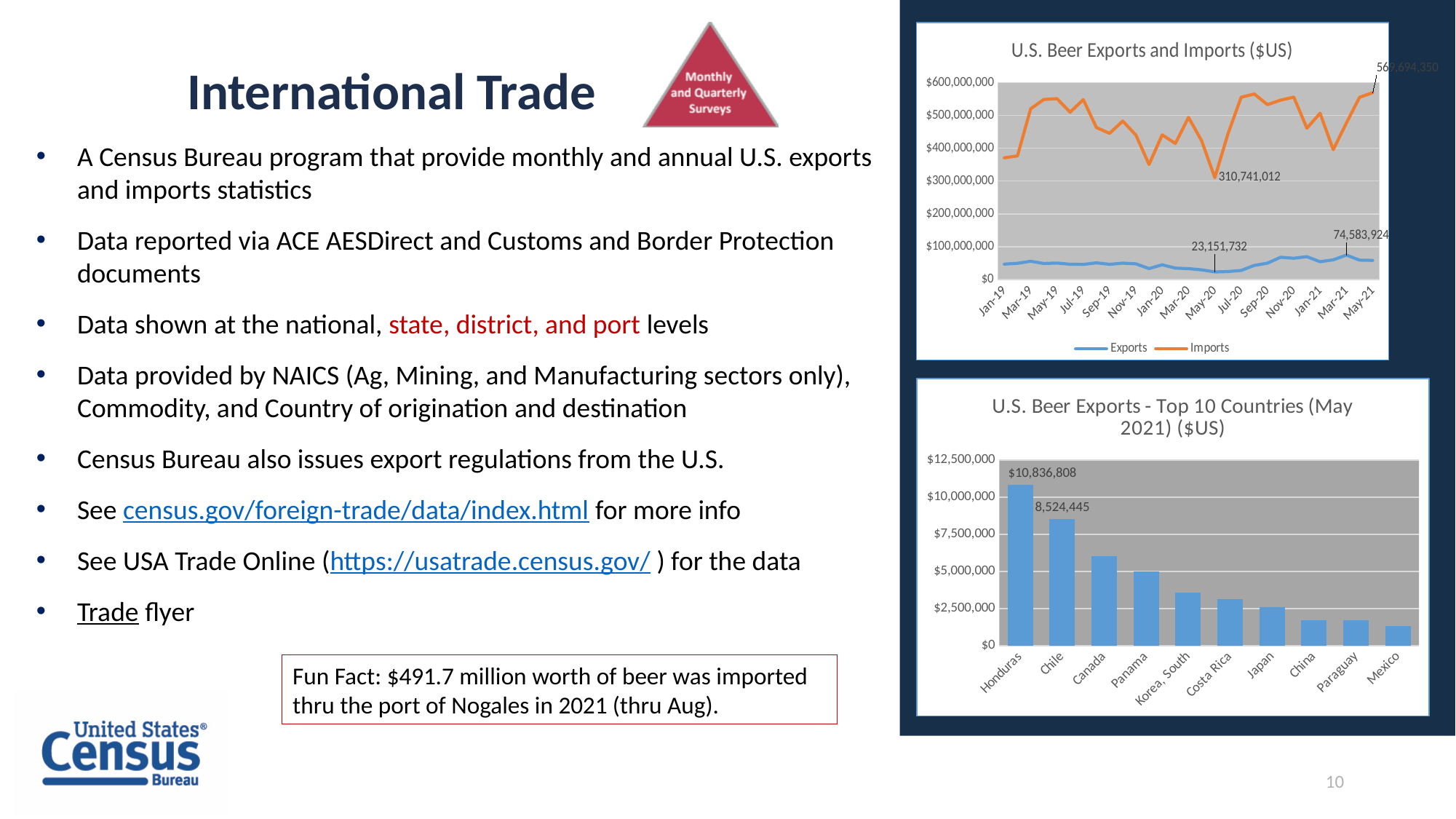
In the 'U.S. Beer Exports - Top 10 Countries (May 2021) ($US)' chart, how many countries are shown? 10 In the 'U.S. Beer Exports - Top 10 Countries (May 2021) ($US)' chart, which country has the lowest value? Mexico In the 'U.S. Beer Exports - Top 10 Countries (May 2021) ($US)' chart, what type of chart is shown? bar chart In the 'U.S. Beer Exports and Imports ($US)' chart, is the Exports value at Jan-19 greater or less than $100,000,000? less In the 'U.S. Beer Exports - Top 10 Countries (May 2021) ($US)' chart, what is the difference between the values for Honduras and Chile? 2,312,363 In the 'U.S. Beer Exports and Imports ($US)' chart, which series has higher values throughout the period, Exports or Imports? Imports In the 'U.S. Beer Exports and Imports ($US)' chart, what is the labeled value of Exports at May-20? 23,151,732 In the 'U.S. Beer Exports and Imports ($US)' chart, what type of chart is shown? line chart In the 'U.S. Beer Exports and Imports ($US)' chart, what is the labeled value of Imports at May-20? 310,741,012 In the 'U.S. Beer Exports and Imports ($US)' chart, how many series does the legend list? 2 In the 'U.S. Beer Exports - Top 10 Countries (May 2021) ($US)' chart, what is the value for Chile? 8,524,445 In the 'U.S. Beer Exports - Top 10 Countries (May 2021) ($US)' chart, what is the value for Honduras? $10,836,808